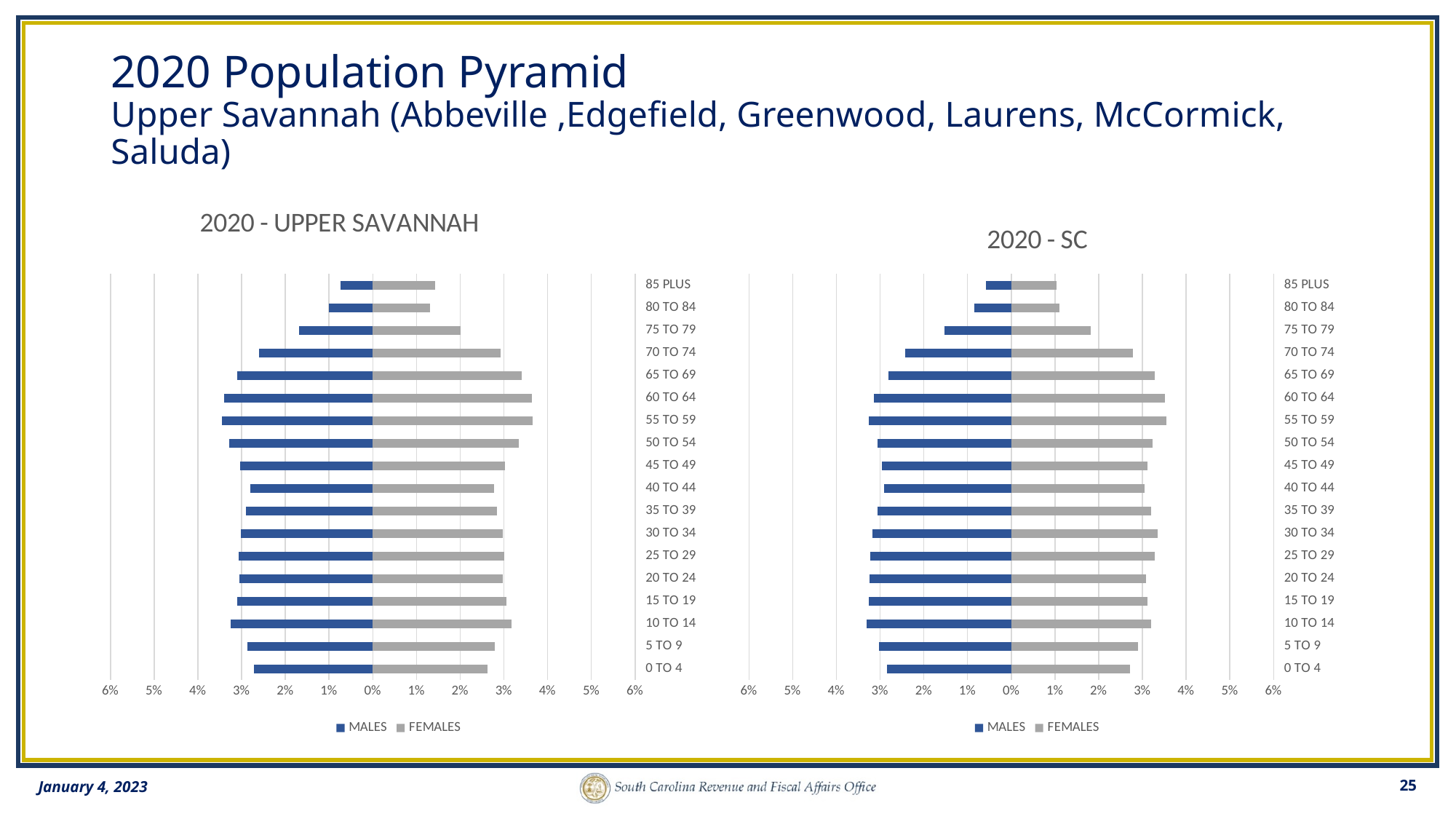
In the 2020 - UPPER SAVANNAH chart, for the 85 PLUS age group, which is larger, the MALES value or the FEMALES value? FEMALES What are the two series named in the legend of the 2020 - UPPER SAVANNAH chart? MALES and FEMALES How many series does the legend of the 2020 - SC chart list? 2 In the 2020 - SC chart, which age group has the smallest MALES value? 85 PLUS In the 2020 - UPPER SAVANNAH chart, is the MALES value for 85 PLUS greater or less than 1%? less What is the title of the chart on the right side of the slide? 2020 - SC In the 2020 - SC chart, is the MALES value for 85 PLUS greater or less than 1%? less How many age-group categories are shown in the 2020 - SC chart? 18 In the 2020 - SC chart, do the MALES bars get longer or shorter going from 60 TO 64 up to 85 PLUS? shorter In the 2020 - SC chart, is the MALES value for 10 TO 14 greater or less than 3%? greater What kind of chart is the 2020 - UPPER SAVANNAH chart? bar chart